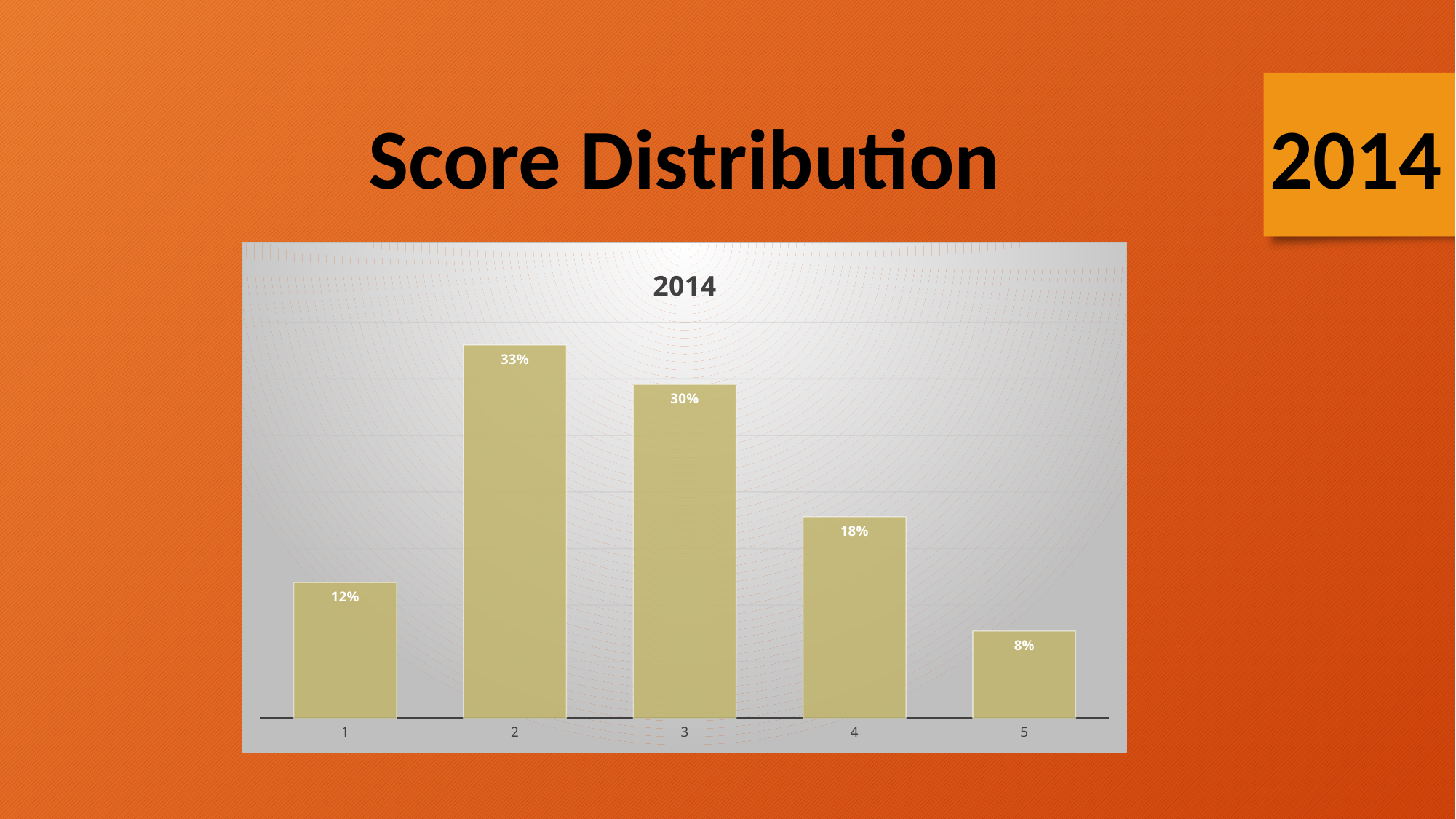
What is the difference between the values for category 1 and category 5? 4% What is the difference between the values for category 2 and category 3? 3% Which category has the highest value? 2 What is the title of the chart? 2014 What is the value for category 2? 33% Which is larger, the value for category 1 or the value for category 4? 4 Do the values rise or fall from category 2 to category 5? fall What kind of chart is shown on the slide? bar chart What is the value for category 4? 18% How many categories are shown on the x axis? 5 What is the value for category 5? 8% Which category has the lowest value? 5